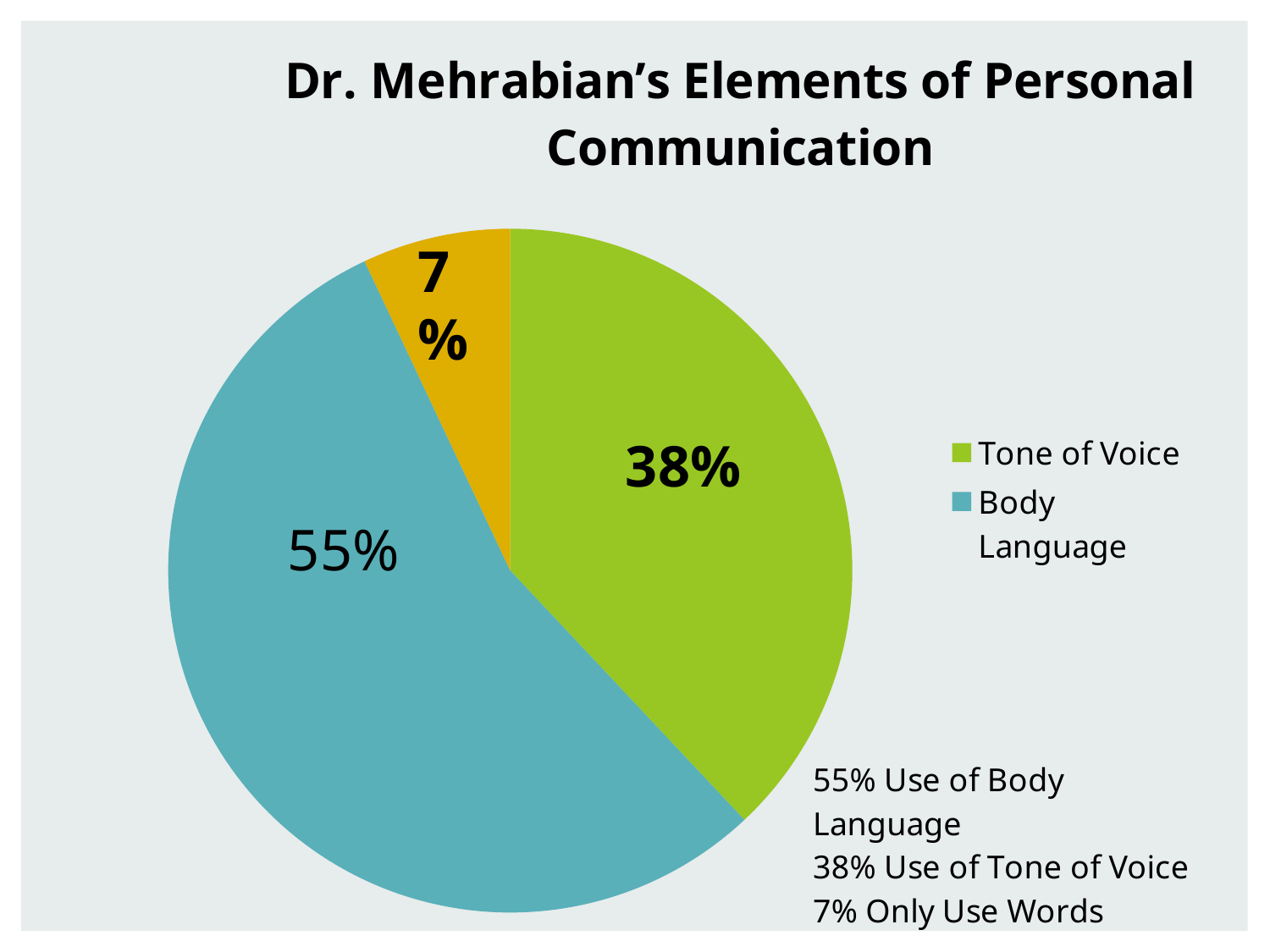
What is the title of the chart? Dr. Mehrabian's Elements of Personal Communication What is the difference in percentage points between Body Language and Tone of Voice? 17 What percentage is shown on the yellow slice of the pie? 7% Which slice of the pie is the smallest? the yellow slice (7%) What percentage is shown for Tone of Voice? 38% What colour is the Tone of Voice slice? green How many slices does the pie chart have? 3 Which is larger, Body Language or Tone of Voice? Body Language Which slice of the pie is the largest? Body Language How many entries does the legend list? 2 What percentage is shown for Body Language? 55% What type of chart is shown on the slide? pie chart